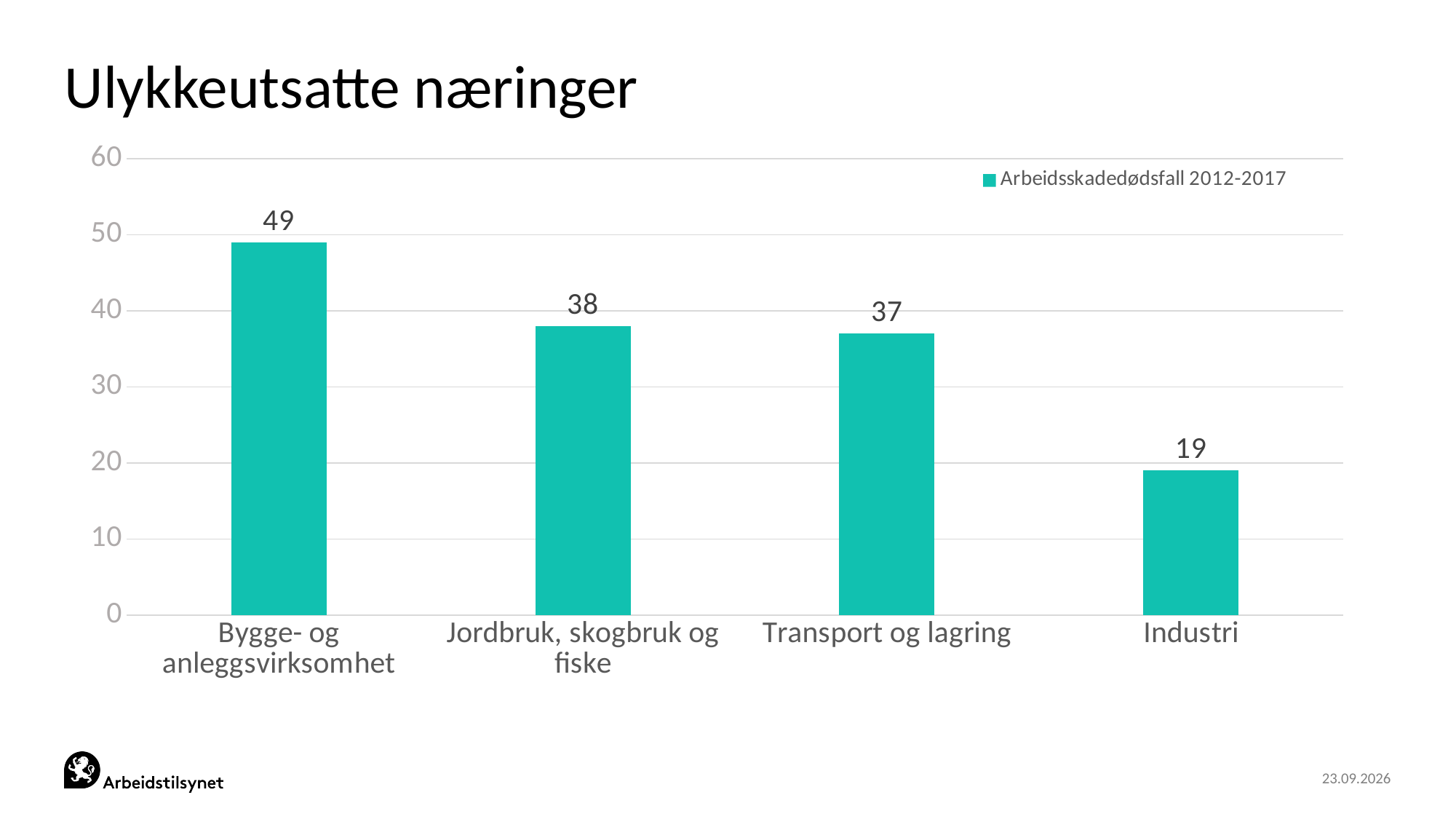
What is the series name shown in the legend? Arbeidsskadedødsfall 2012-2017 What kind of chart is shown on the slide? Bar chart Which category has the lowest value? Industri What is the difference between the values for Bygge- og anleggsvirksomhet and Industri? 30 What is the value for Transport og lagring? 37 Which category has the highest value? Bygge- og anleggsvirksomhet What is the value for Bygge- og anleggsvirksomhet? 49 What is the value for Industri? 19 What is the difference between the values for Jordbruk, skogbruk og fiske and Transport og lagring? 1 How many categories are shown on the x axis? 4 Which is larger: the value for Bygge- og anleggsvirksomhet or the value for Jordbruk, skogbruk og fiske? Bygge- og anleggsvirksomhet What is the value for Jordbruk, skogbruk og fiske? 38